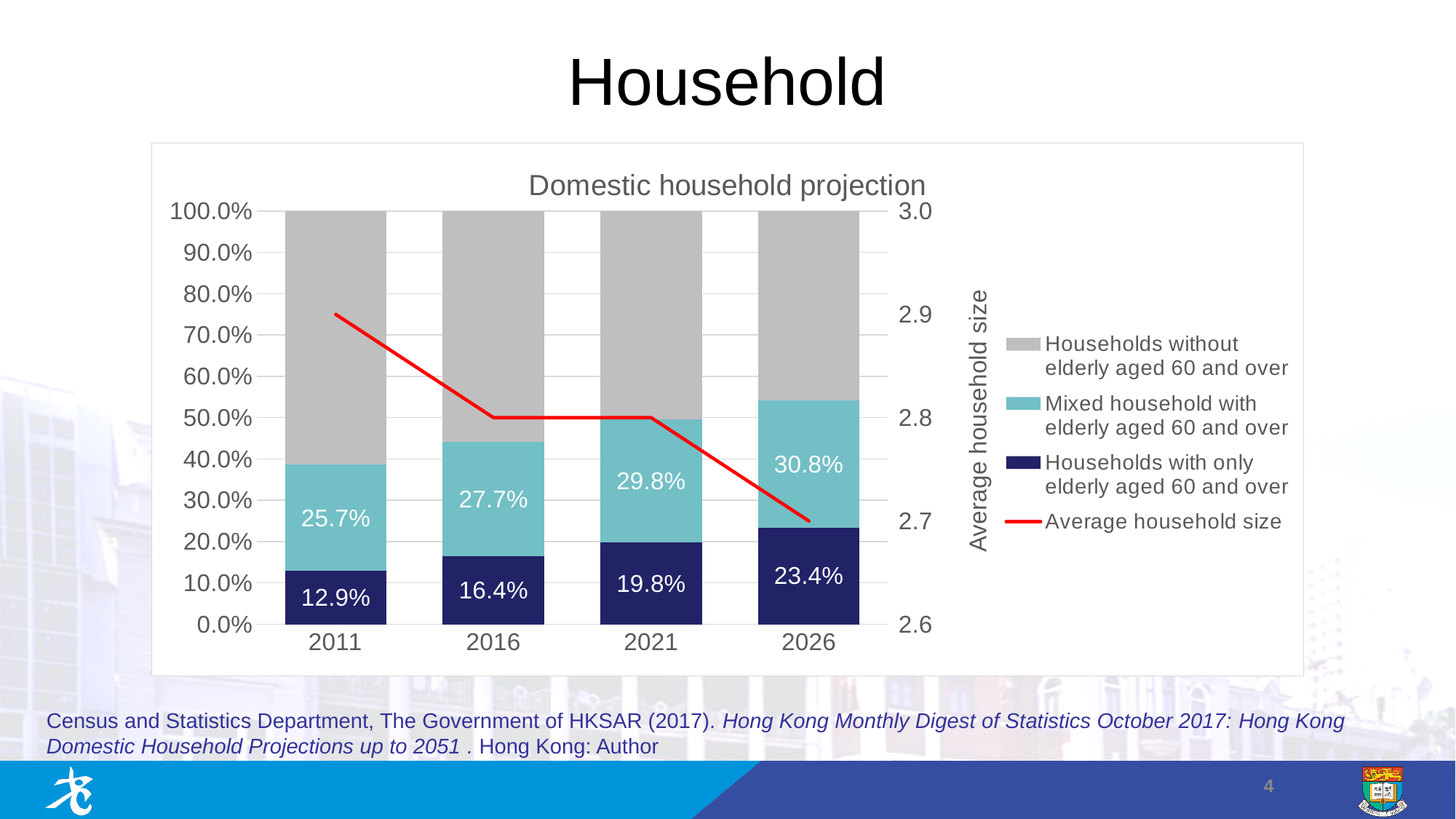
By how many percentage points does the share of Households with only elderly aged 60 and over in 2026 exceed that in 2011? 10.5 percentage points What is the value for Households with only elderly aged 60 and over in 2021? 19.8% What is the value for Mixed household with elderly aged 60 and over in 2016? 27.7% Which is larger: Mixed household with elderly aged 60 and over in 2021, or Households with only elderly aged 60 and over in 2026? Mixed household with elderly aged 60 and over in 2021 How many series does the legend list? 4 How many years are shown on the x axis? 4 What is the title of the chart? Domestic household projection In which year is the share of Mixed household with elderly aged 60 and over the lowest? 2011 Does the share of Households with only elderly aged 60 and over rise or fall from 2011 to 2026? Rise Does the Average household size line rise or fall from 2011 to 2026? Fall In which year is the share of Households with only elderly aged 60 and over the highest? 2026 Is the Average household size in 2011 greater or less than 2.8? greater